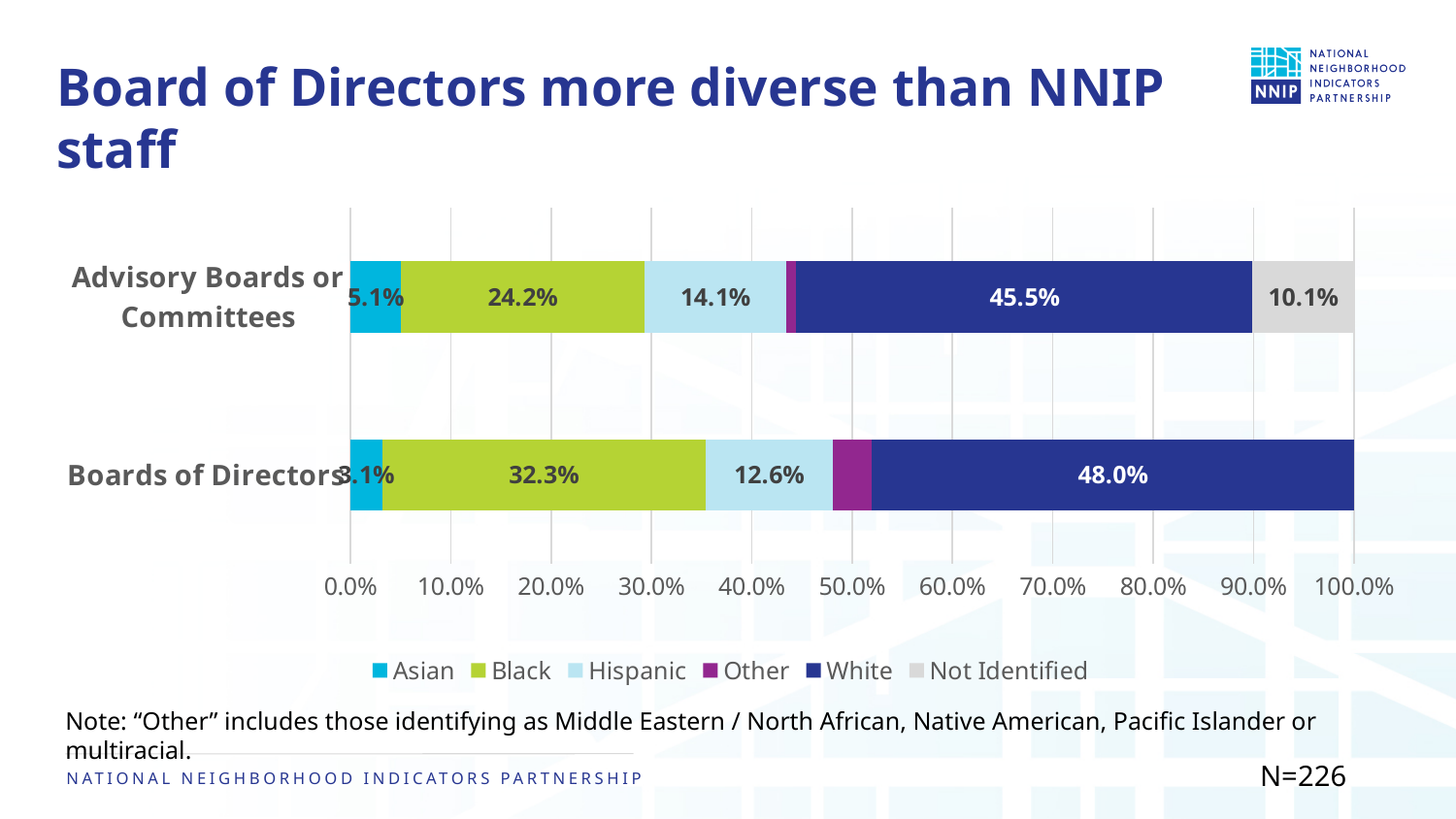
Which racial/ethnic group makes up the largest segment of the Advisory Boards or Committees bar? White How many percentage points higher is the White share for Boards of Directors than for Advisory Boards or Committees? 2.5 percentage points What percentage of Advisory Boards or Committees members are Black? 24.2% Is the 'Other' segment for Boards of Directors greater or less than 10.0%? less How many series does the legend list? 6 What percentage of Boards of Directors members are White? 48.0% Which group has the larger Hispanic share: Advisory Boards or Committees, or Boards of Directors? Advisory Boards or Committees What is the difference between the Black share for Boards of Directors and for Advisory Boards or Committees? 8.1 percentage points Which group has the larger Black share: Advisory Boards or Committees, or Boards of Directors? Boards of Directors What share of Advisory Boards or Committees members are Not Identified? 10.1% What kind of chart is shown on the slide? Stacked bar chart What is the Hispanic share for Boards of Directors? 12.6%